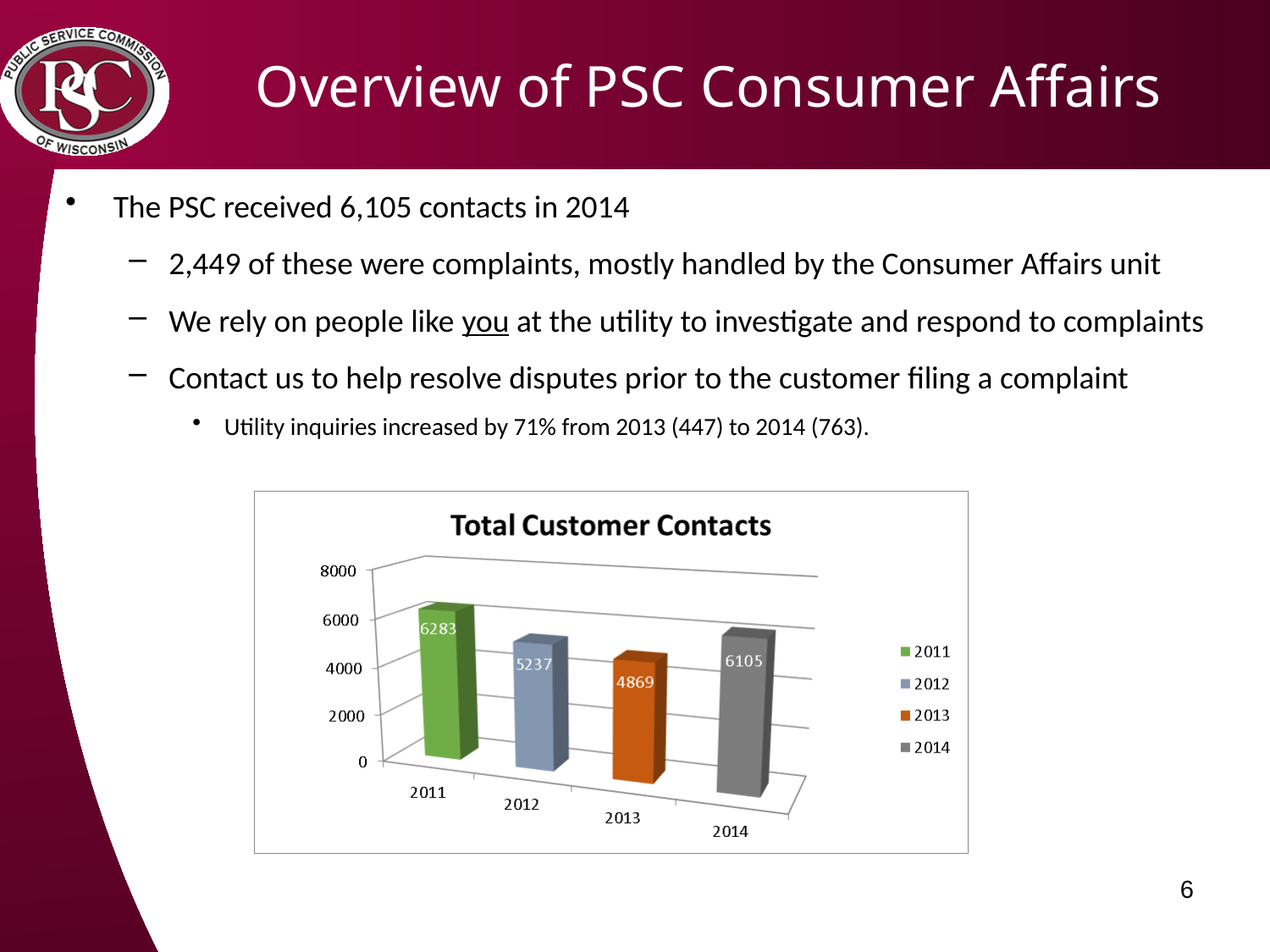
What is the difference between the 2014 and 2013 values in the Total Customer Contacts chart? 1236 What is the value for 2011 in the Total Customer Contacts chart? 6283 What kind of chart is the Total Customer Contacts chart? bar chart How many entries does the legend of the Total Customer Contacts chart list? 4 What is the value for 2012 in the Total Customer Contacts chart? 5237 What is the title of the chart on the slide? Total Customer Contacts What is the value for 2013 in the Total Customer Contacts chart? 4869 How many years are shown in the Total Customer Contacts chart? 4 Which is larger, the value for 2012 or the value for 2014? 2014 Is the value for 2013 greater or less than 6000? less Which year has the lowest total customer contacts? 2013 Which year has the highest total customer contacts? 2011